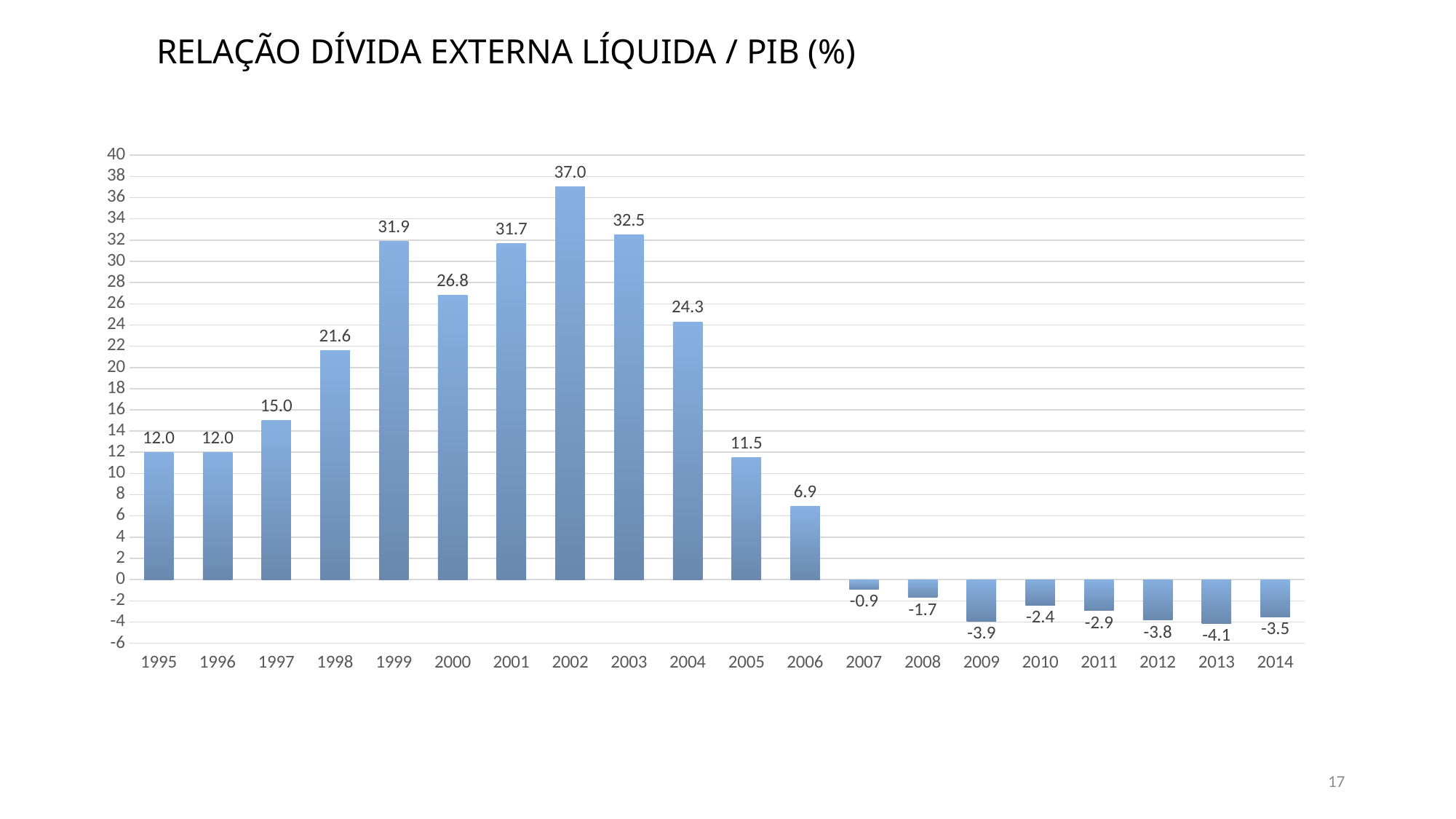
What is the value for 1998? 21.6 How many years are shown on the x axis? 20 What is the value for 2013? -4.1 Do the values rise or fall from 2006 to 2009? fall What kind of chart is shown on the slide? bar chart What is the value for 2002? 37.0 What is the title of the chart? RELAÇÃO DÍVIDA EXTERNA LÍQUIDA / PIB (%) Which is larger, the value for 1999 or the value for 2001? 1999 What is the difference between the values for 2005 and 2006? 4.6 Which year has the lowest value? 2013 What is the difference between the values for 2002 and 2003? 4.5 Which year has the highest value? 2002